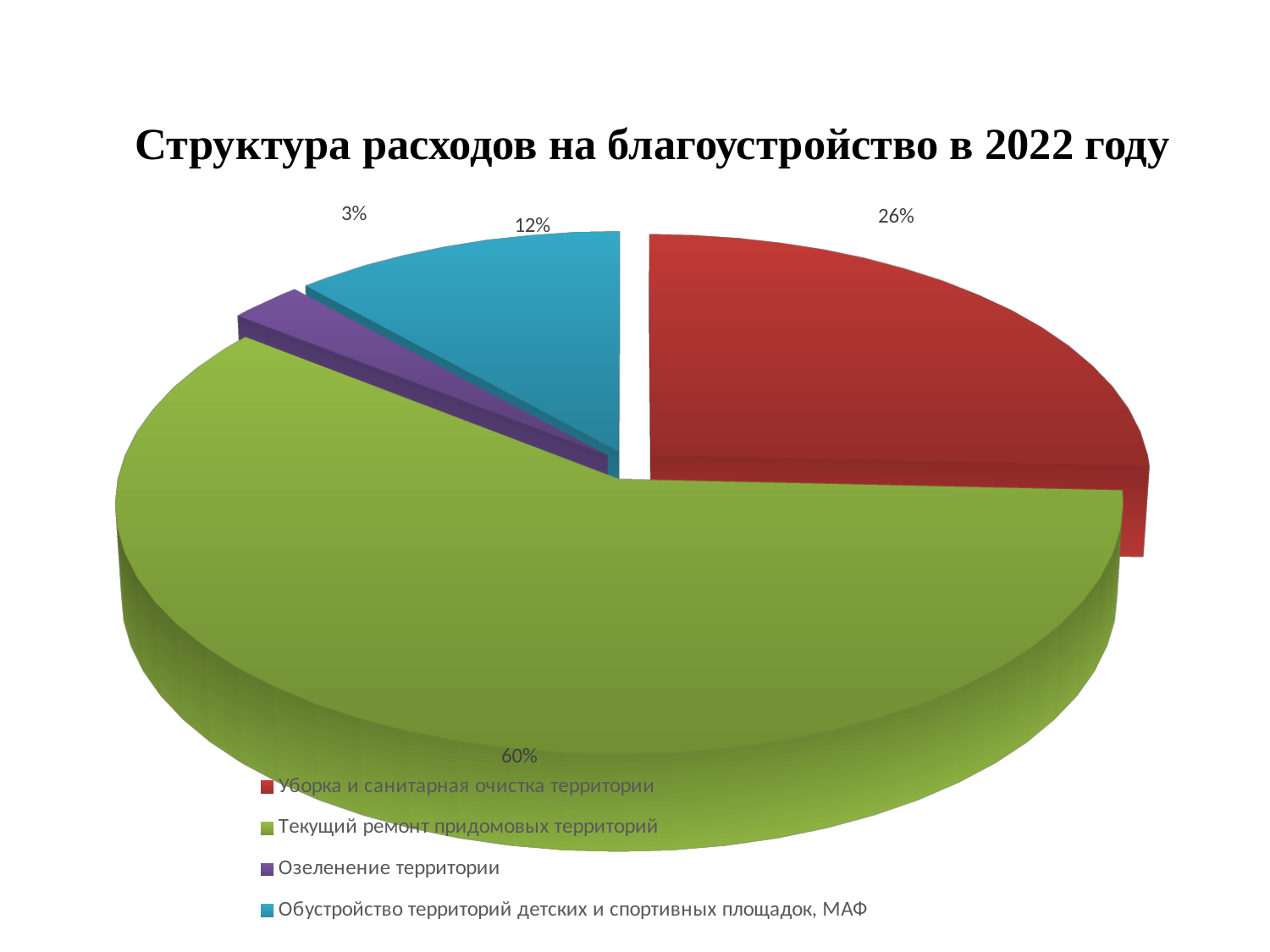
What is the difference in percentage points between Текущий ремонт придомовых территорий and Уборка и санитарная очистка территории? 34 percentage points What share of expenses is for Текущий ремонт придомовых территорий? 60% What share of expenses is for Уборка и санитарная очистка территории? 26% Which is larger: the share for Уборка и санитарная очистка территории or the share for Обустройство территорий детских и спортивных площадок, МАФ? Уборка и санитарная очистка территории Which category has the smallest share of expenses? Озеленение территории How many categories does the pie chart show? 4 What is the title of the chart? Структура расходов на благоустройство в 2022 году Which category has the largest share of expenses? Текущий ремонт придомовых территорий What share of expenses is for Озеленение территории? 3% What kind of chart is shown on the slide? Pie chart What colour is the slice for Озеленение территории? Purple